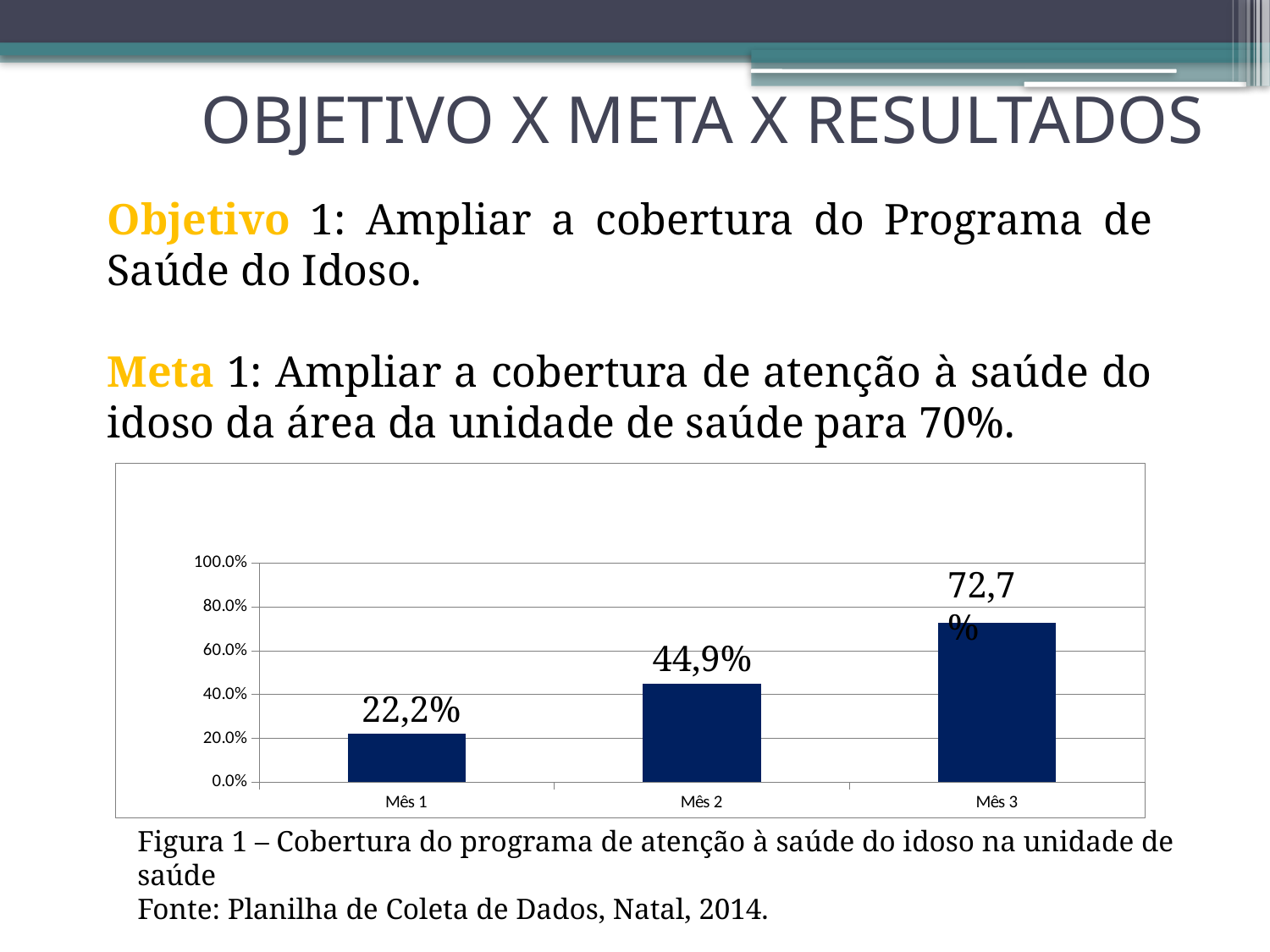
What is the value for Mês 1? 22,2% Which month has the lowest value? Mês 1 What is the value for Mês 2? 44,9% Do the values rise or fall from Mês 1 to Mês 3? Rise What is the value for Mês 3? 72,7% Which month has the highest value? Mês 3 Which is larger, the value for Mês 2 or the value for Mês 3? Mês 3 Is the value for Mês 3 greater or less than 60.0%? greater How many months are shown on the x axis? 3 What is the difference between the values for Mês 3 and Mês 1? 50,5% What kind of chart is shown on the slide? Bar chart What is the difference between the values for Mês 2 and Mês 1? 22,7%